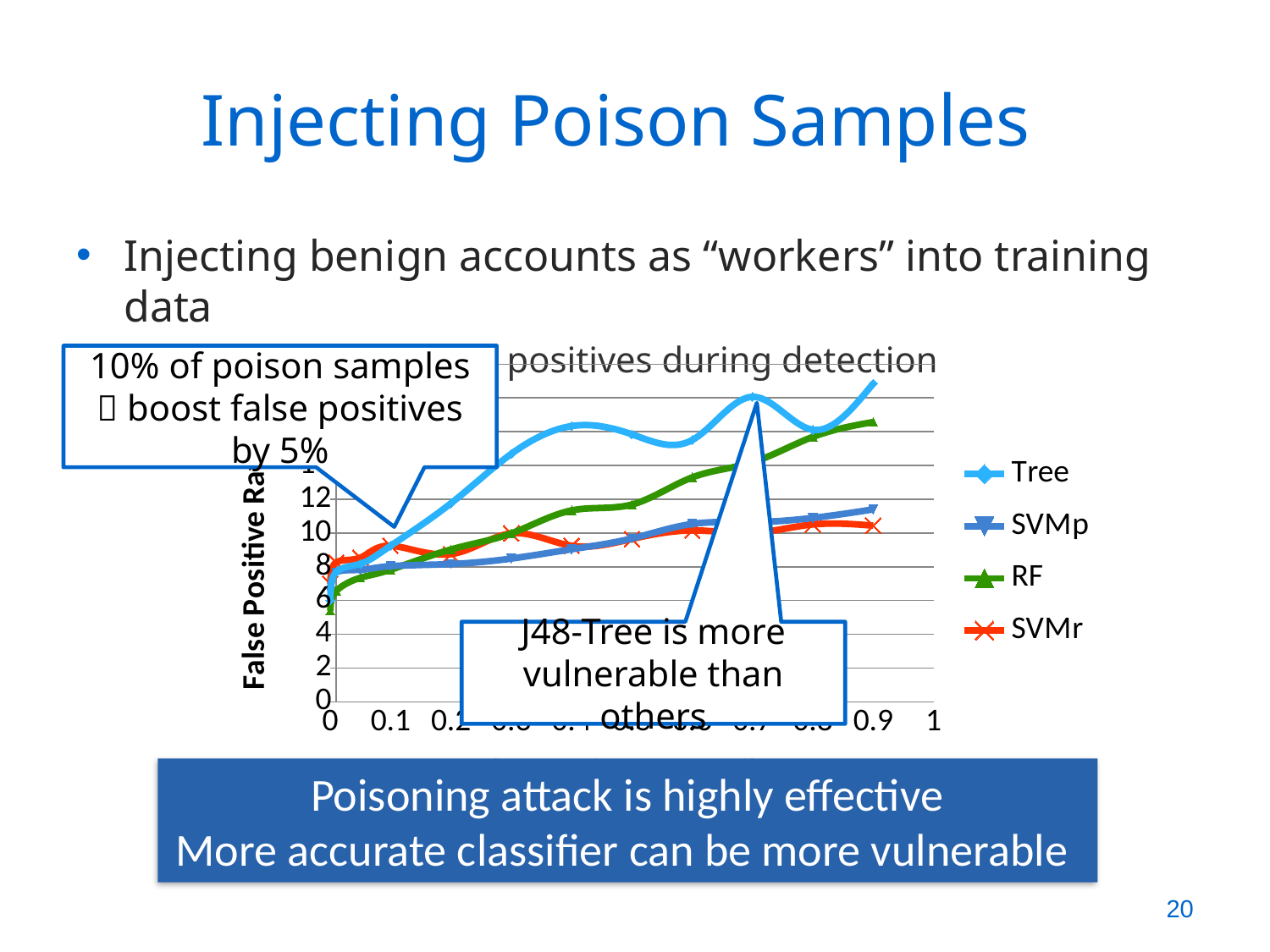
Is the value of the Tree series at x = 0.9 greater or less than 12? greater Which series are listed in the chart's legend? Tree, SVMp, RF, SVMr How many series does the chart's legend list? 4 Is the value of the SVMr series at x = 0.9 greater or less than 12? less Which series has the lowest value at x = 0? RF Is the value of the RF series at x = 0.9 greater or less than 12? greater What kind of chart is shown on the slide? line chart At x = 0.7, which series has the larger value, Tree or RF? Tree Which series has the highest value at x = 0.9? Tree Does the RF series generally rise or fall as x increases from 0 to 0.9? rise